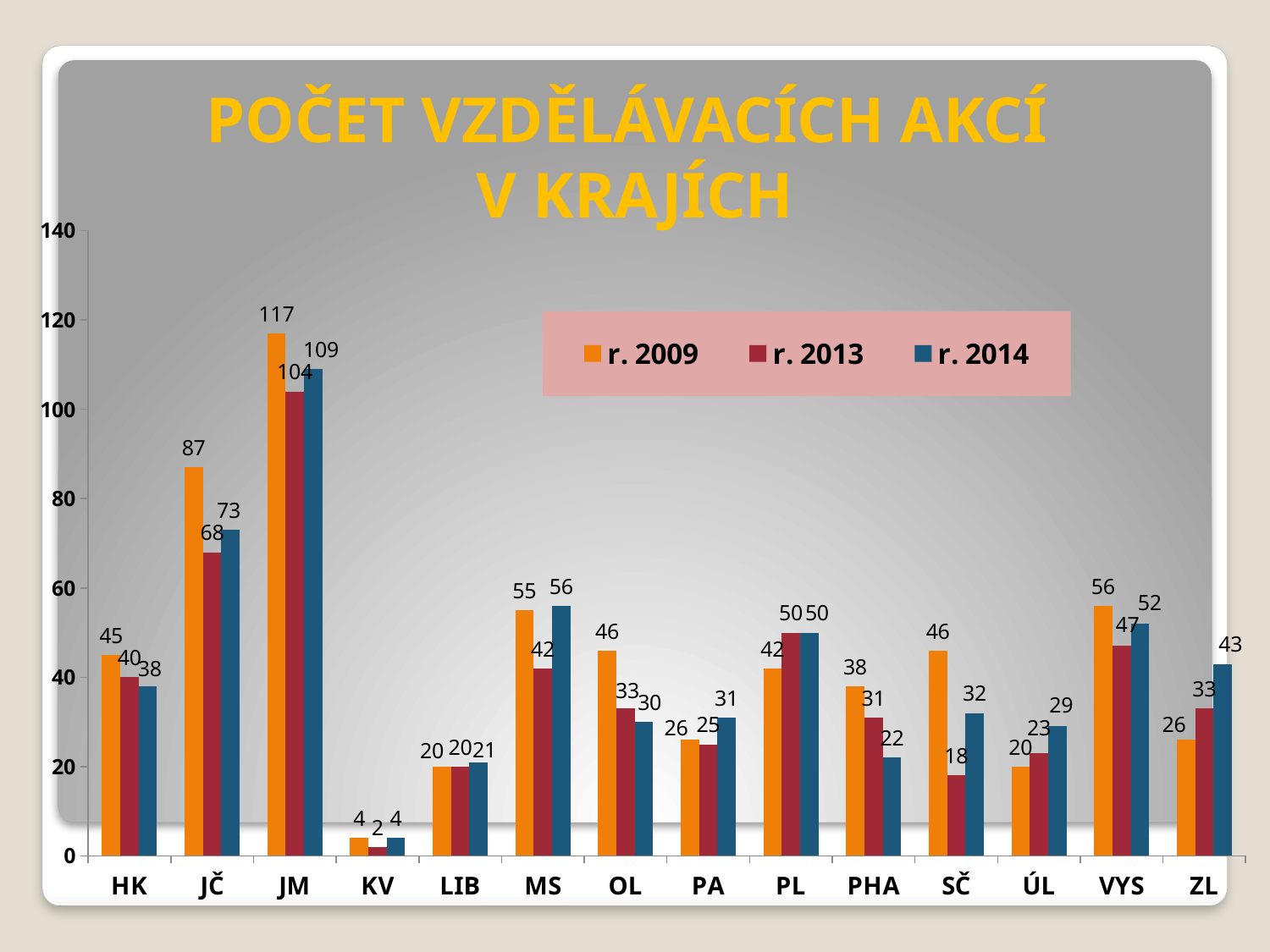
What is the title of the chart? POČET VZDĚLÁVACÍCH AKCÍ V KRAJÍCH What kind of chart is shown on the slide? bar chart How many regions are shown on the x axis? 14 How many series does the legend list? 3 What is the value for ZL in the r. 2014 series? 43 What is the value for JM in the r. 2009 series? 117 Which region has the highest value in the r. 2014 series? JM Which is larger for PHA: the r. 2009 value or the r. 2014 value? r. 2009 What is the value for SČ in the r. 2013 series? 18 Which region has the lowest value in the r. 2009 series? KV What is the difference between the r. 2009 and r. 2014 values for JČ? 14 Is the value for MS in the r. 2014 series greater or less than 40? greater